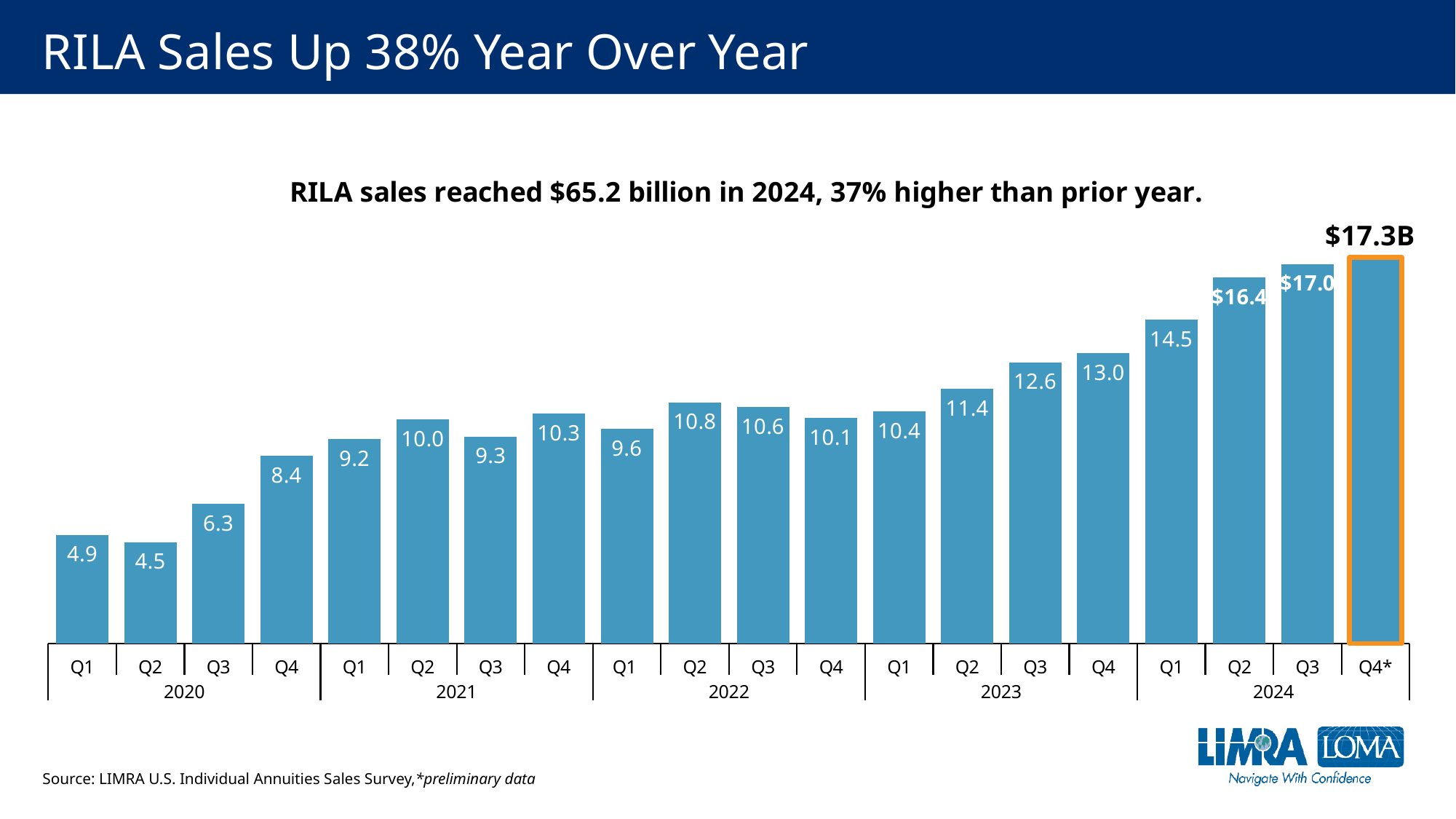
Which quarter has the highest value? Q4* 2024 Which quarter has the lowest value? Q2 2020 What is the chart's subtitle text above the bars? RILA sales reached $65.2 billion in 2024, 37% higher than prior year. What is the value for Q4 2021? 10.3 What is the value for Q1 2020? 4.9 What is the difference between Q1 2024 and Q1 2023? 4.1 What is the value for Q3 2024? $17.0 How many quarterly bars are plotted on the chart? 20 What kind of chart is shown on the slide? Bar chart What is the value for Q4* 2024? $17.3B Do the values generally rise or fall from Q1 2020 to Q4 2024? Rise Which is larger, Q3 2022 or Q4 2022? Q3 2022